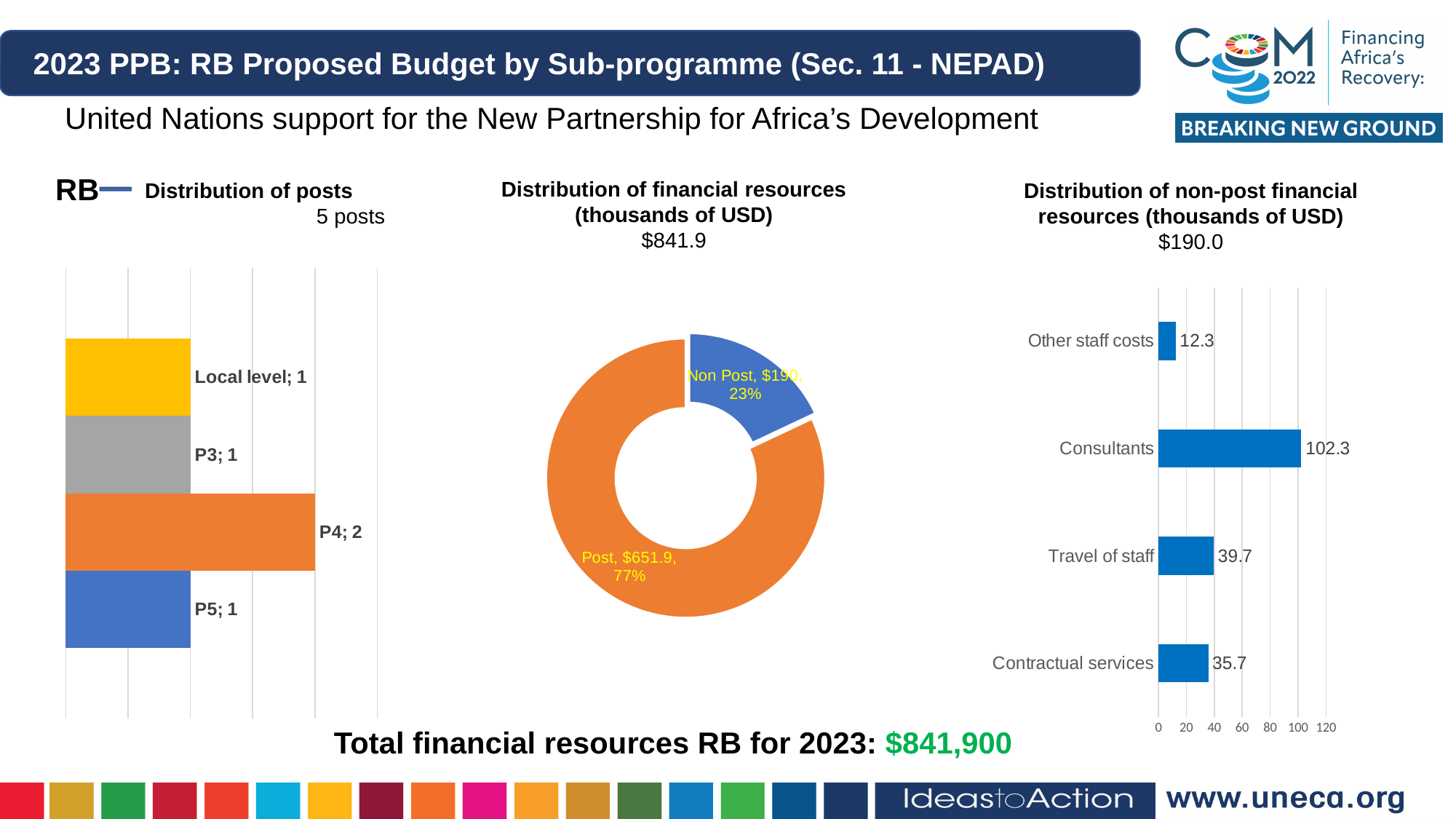
In the 'Distribution of financial resources' chart, what share of the total is Non Post? 23% What kind of chart is the 'Distribution of financial resources' chart? doughnut chart In the 'Distribution of non-post financial resources' chart, which is larger: Travel of staff or Other staff costs? Travel of staff How many categories are shown in the 'Distribution of non-post financial resources' chart? 4 In the 'Distribution of financial resources' chart, what is the value for Post? $651.9 In the 'Distribution of non-post financial resources' chart, what is the difference between Travel of staff and Contractual services? 4.0 In the 'Distribution of posts' chart, how many posts are at the P4 level? 2 In the 'Distribution of non-post financial resources' chart, which category has the lowest value? Other staff costs In the 'Distribution of non-post financial resources' chart, what is the value for Consultants? 102.3 How many categories are shown in the 'Distribution of posts' chart? 4 What kind of chart is the 'Distribution of posts' chart? bar chart In the 'Distribution of posts' chart, which category has the highest number of posts? P4